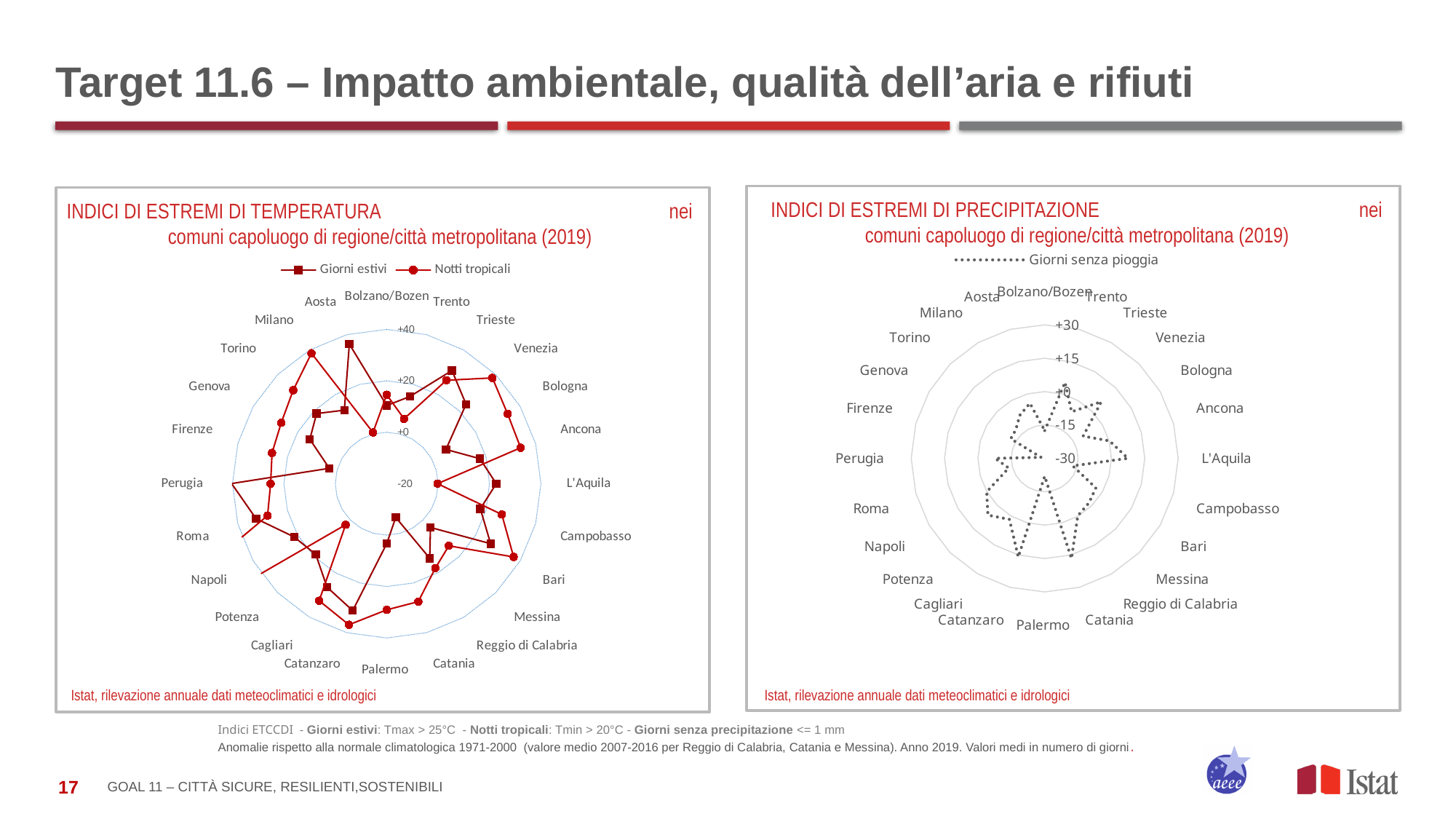
Which series are listed in the legend of the left chart (temperature extremes)? Giorni estivi and Notti tropicali In the right chart (precipitation extremes), is the 'Giorni senza pioggia' value for Catania greater or less than 0? greater How many cities are plotted around the right chart (precipitation extremes)? 24 What is the name of the series plotted in the right chart (precipitation extremes)? Giorni senza pioggia What kind of chart is the left chart, 'INDICI DI ESTREMI DI TEMPERATURA'? Radar chart How many cities are plotted around the left chart (temperature extremes)? 24 How many series does the legend of the left chart (temperature extremes) list? 2 In the left chart (temperature extremes), is the 'Giorni estivi' value for Aosta greater or less than +20? greater How many series does the legend of the right chart (precipitation extremes) list? 1 What kind of chart is the right chart, 'INDICI DI ESTREMI DI PRECIPITAZIONE'? Radar chart In the left chart (temperature extremes), is the 'Notti tropicali' value for Perugia greater or less than +20? greater